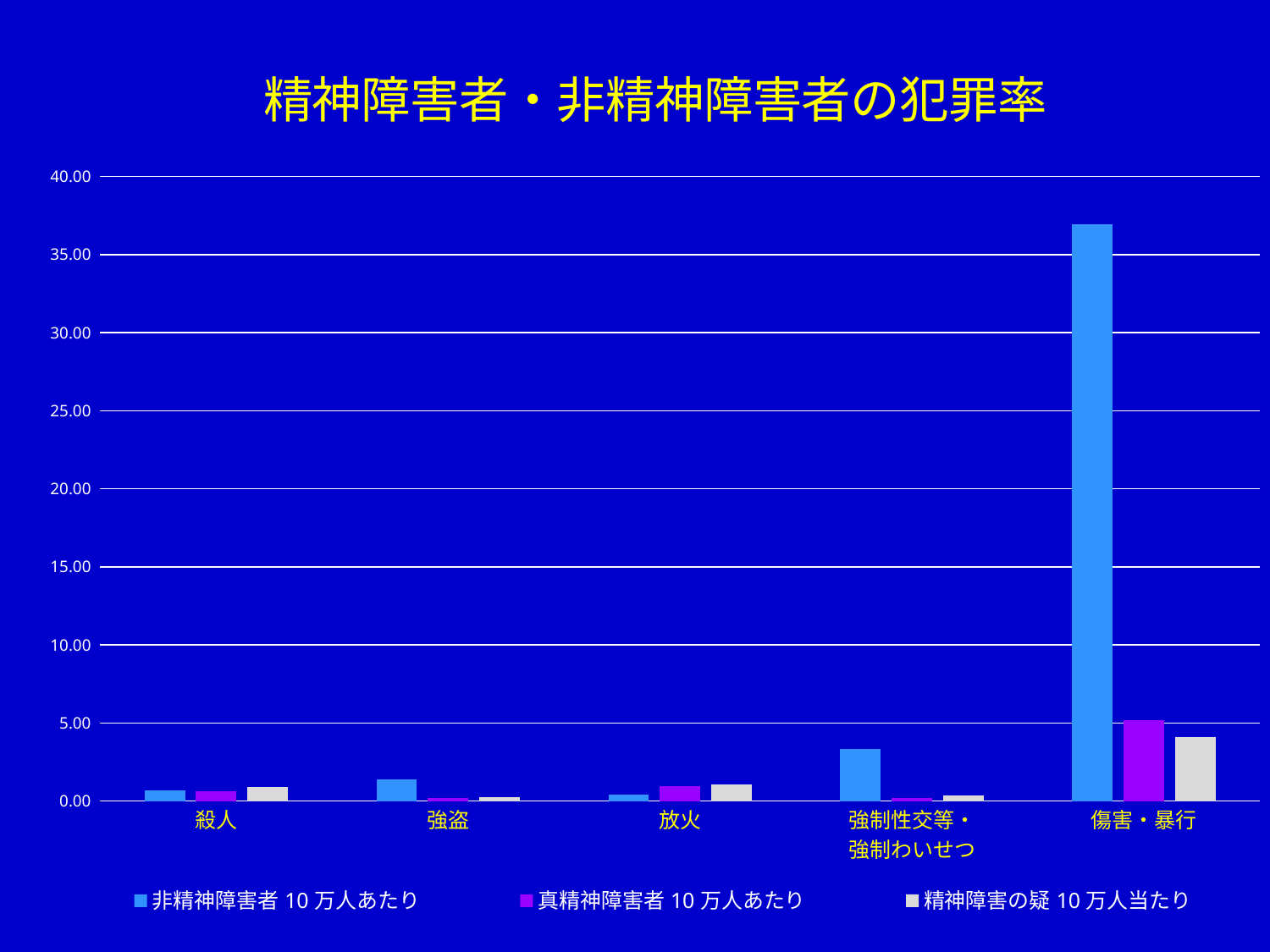
Is the value for 非精神障害者 10 万人あたり in 強制性交等・強制わいせつ greater or less than 5.00? less Is the value for 非精神障害者 10 万人あたり in 傷害・暴行 greater or less than 35.00? greater How many series does the legend list? 3 Which category has the highest value for 真精神障害者 10 万人あたり? 傷害・暴行 What is the title of the chart? 精神障害者・非精神障害者の犯罪率 Which category has the highest value for 非精神障害者 10 万人あたり? 傷害・暴行 In 傷害・暴行, which is larger: 非精神障害者 10 万人あたり or 真精神障害者 10 万人あたり? 非精神障害者 10 万人あたり What colour represents the series 真精神障害者 10 万人あたり in the legend? purple What kind of chart is shown on the slide? bar chart Is the value for 精神障害の疑 10 万人当たり in 傷害・暴行 greater or less than 5.00? less How many categories are shown on the x axis? 5 In 強盗, which is larger: 非精神障害者 10 万人あたり or 真精神障害者 10 万人あたり? 非精神障害者 10 万人あたり